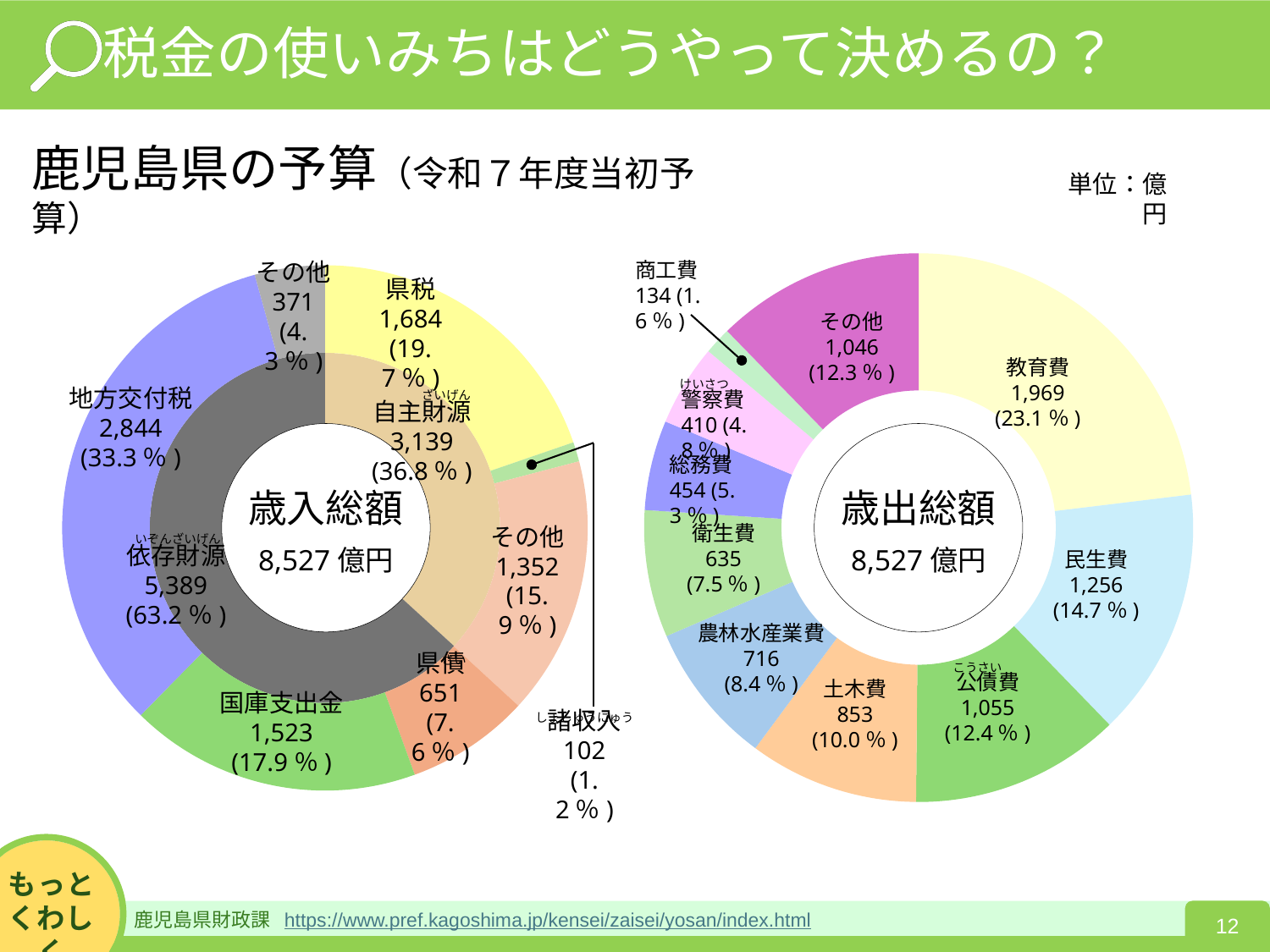
In the 歳入総額 chart, what is the difference between 依存財源 and 自主財源? 2,250 In the 歳出総額 chart, what is the difference between 公債費 and 衛生費? 420 In the 歳出総額 chart, which is larger, 土木費 or 農林水産業費? 土木費 What total amount is shown in the center of the 歳出総額 chart? 8,527 億円 In the 歳入総額 chart, which outer-ring category has the smallest value? 諸収入 In the 歳入総額 chart, what is the value for 地方交付税? 2,844 In the 歳出総額 chart, what share does 民生費 account for? 14.7% What type of chart is used on this slide for 歳入総額 and 歳出総額? Doughnut (pie) chart In the 歳入総額 chart, what share does 県税 account for? 19.7% In the 歳出総額 chart, what is the value for 教育費? 1,969 In the 歳出総額 chart, which category has the smallest value? 商工費 In the 歳入総額 chart, which outer-ring category has the largest value? 地方交付税